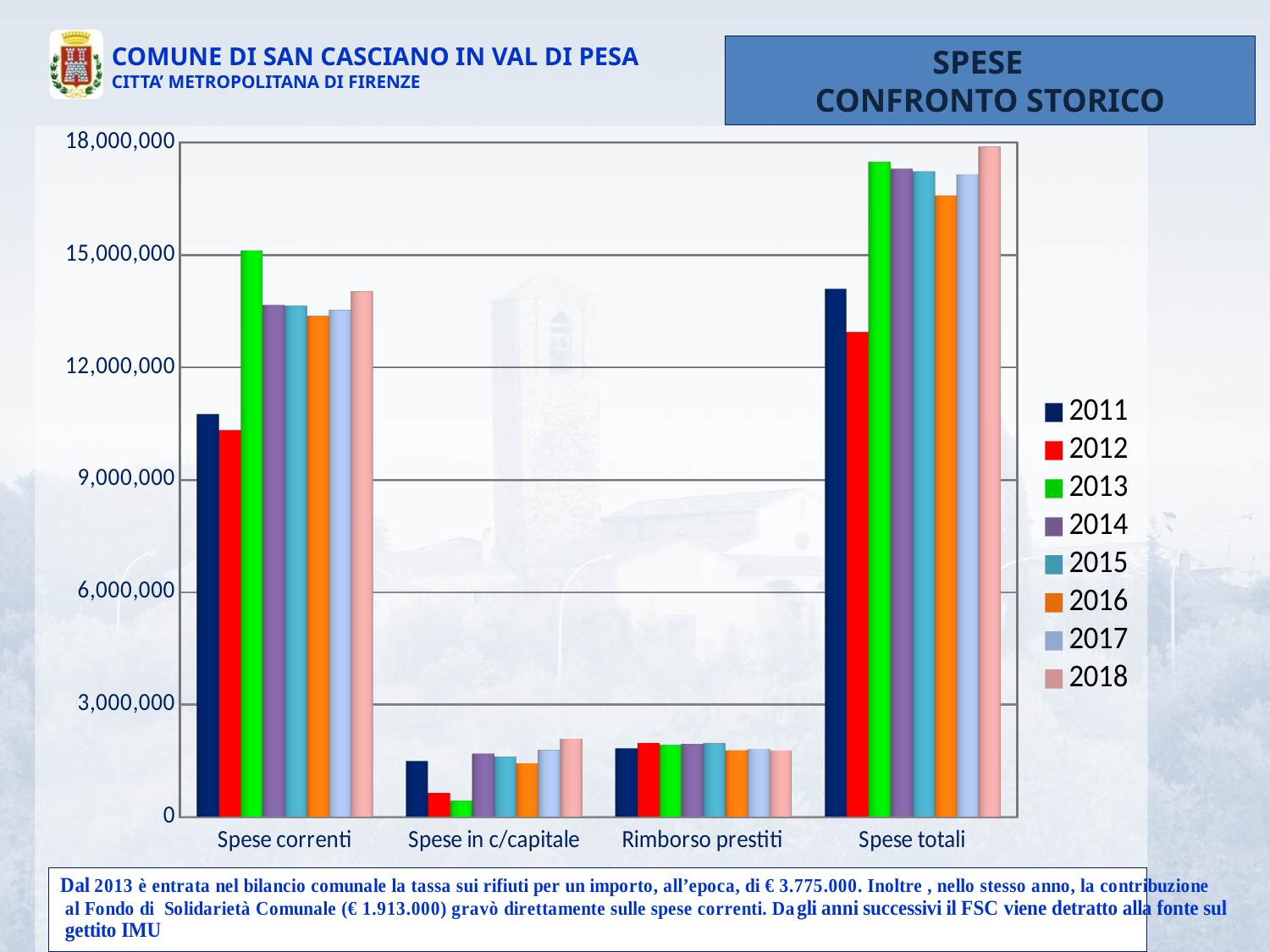
For Spese totali, which is larger: the value for 2011 or the value for 2012? 2011 What kind of chart is shown on the slide? bar chart Which year has the highest value for Spese correnti? 2013 Which year has the lowest value for Spese in c/capitale? 2013 Which year has the lowest value for Spese totali? 2012 Is the value for Spese correnti in 2018 greater or less than 15,000,000? less How many categories are shown on the x axis of the chart? 4 Is the value for Spese correnti in 2011 greater or less than 9,000,000? greater Which year has the lowest value for Spese correnti? 2012 How many series does the legend list? 8 What is the title of the chart shown on the slide? SPESE CONFRONTO STORICO Is the value for Spese totali in 2016 greater or less than 18,000,000? less